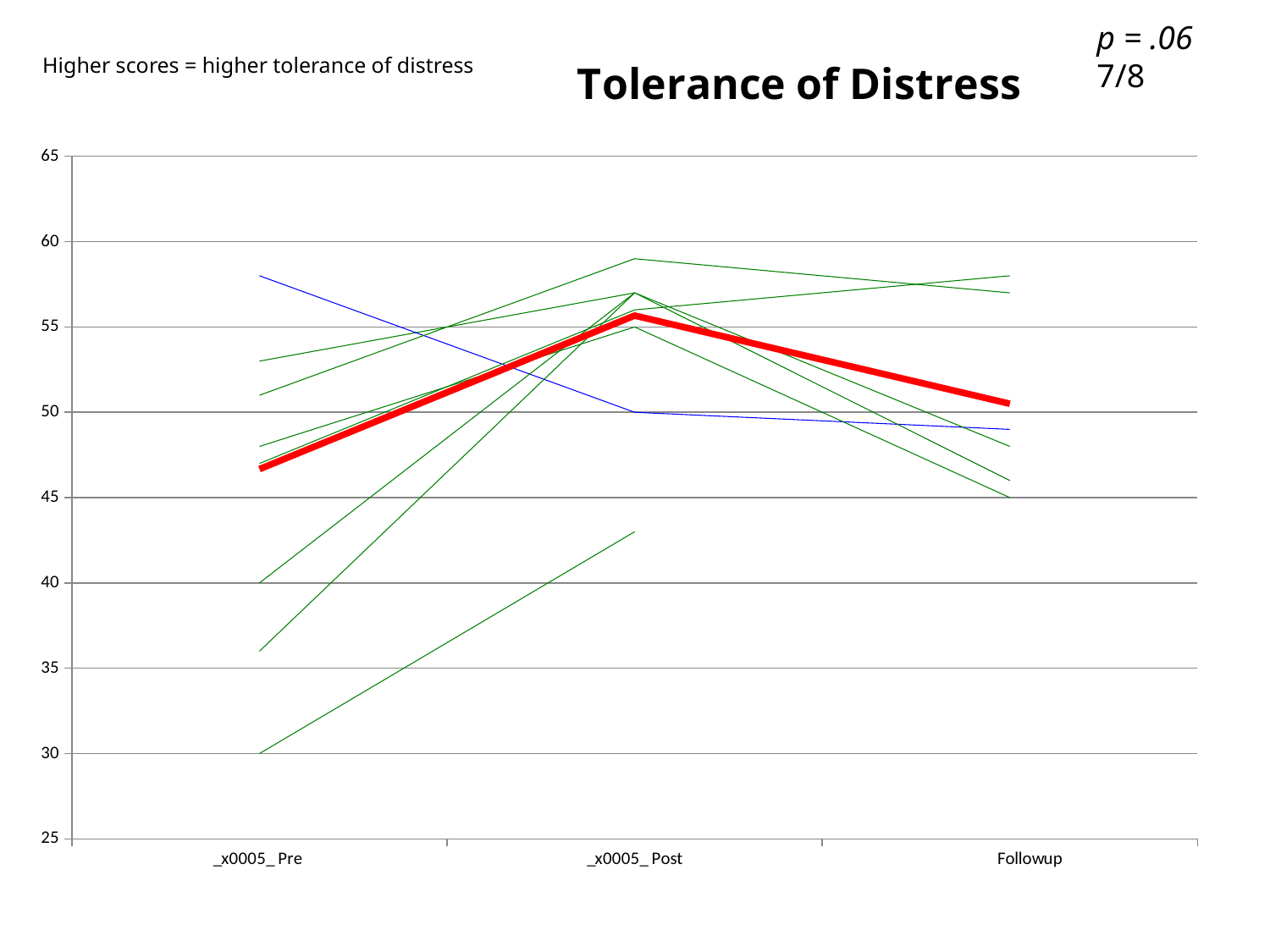
Is the value of the thick red line at _x0005_ Post greater or less than 50? greater Does the thick red line rise or fall from _x0005_ Pre to _x0005_ Post? rise Is the value of the lowest green line at _x0005_ Post greater or less than 45? less How many categories are shown on the x axis? 3 Does the thick red line rise or fall from _x0005_ Post to Followup? fall What kind of chart is shown on the slide? line chart What is the title of the chart? Tolerance of Distress Does the blue line rise or fall from _x0005_ Pre to _x0005_ Post? fall Is the value of the thick red line at _x0005_ Pre greater or less than 50? less What is the value of the lowest line at _x0005_ Pre? 30 What colour is the thick line on the chart? red